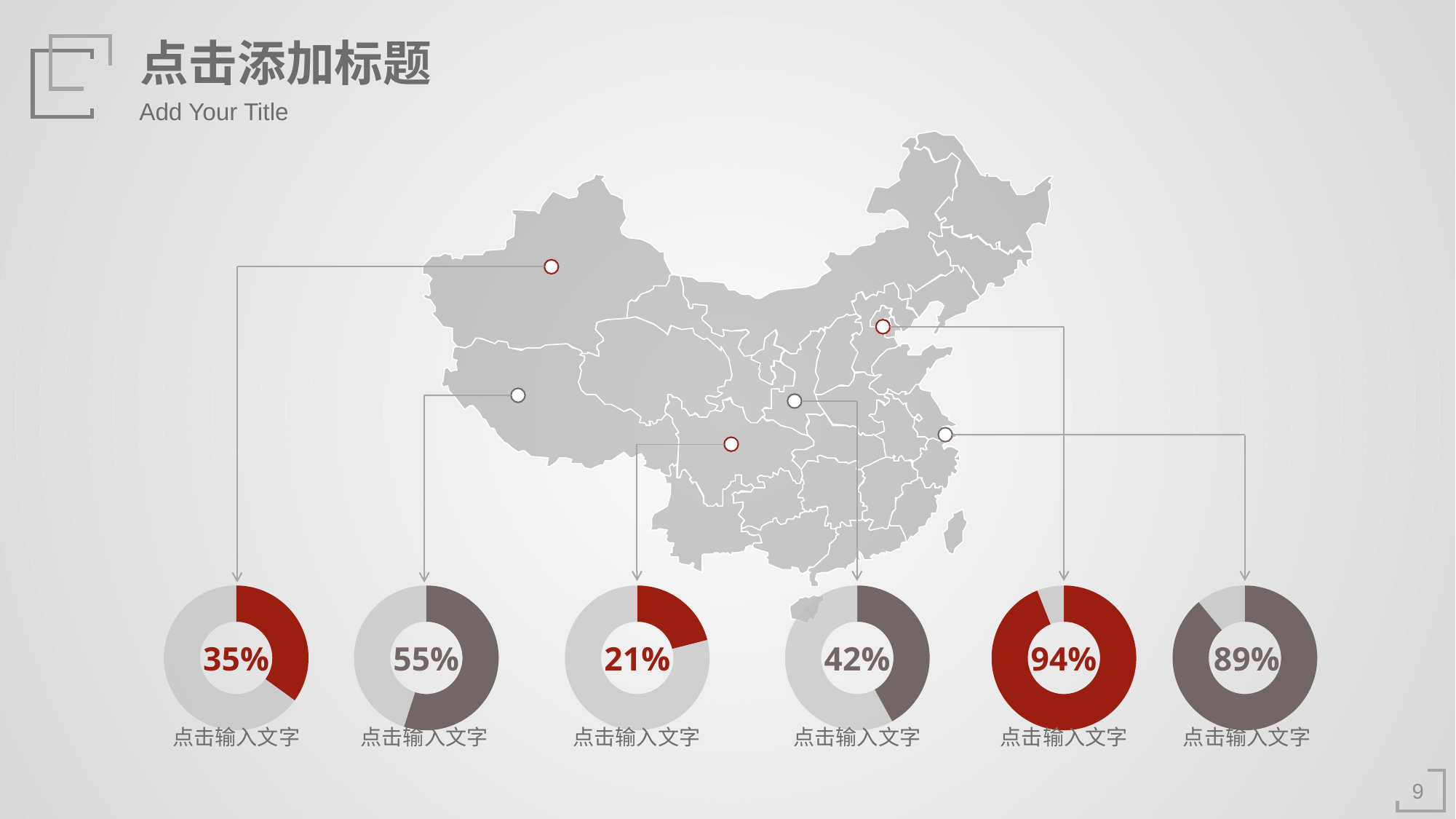
What value is shown in the leftmost donut chart? 35% What value is shown in the fourth donut chart from the left? 42% What value is shown in the fifth donut chart from the left? 94% What colour is the filled portion of the third donut chart from the left (21%)? Red What value is shown in the rightmost donut chart? 89% What value is shown in the third donut chart from the left? 21% Which donut chart shows the lowest percentage? The third from the left (21%) What value is shown in the second donut chart from the left? 55% Which donut chart shows the highest percentage? The fifth from the left (94%) Which is larger, the value in the leftmost donut chart or the value in the fourth donut chart from the left? The fourth donut chart (42%) How many donut charts are shown on the slide? 6 What is the difference between the value in the fifth donut chart (94%) and the value in the rightmost donut chart (89%)? 5%